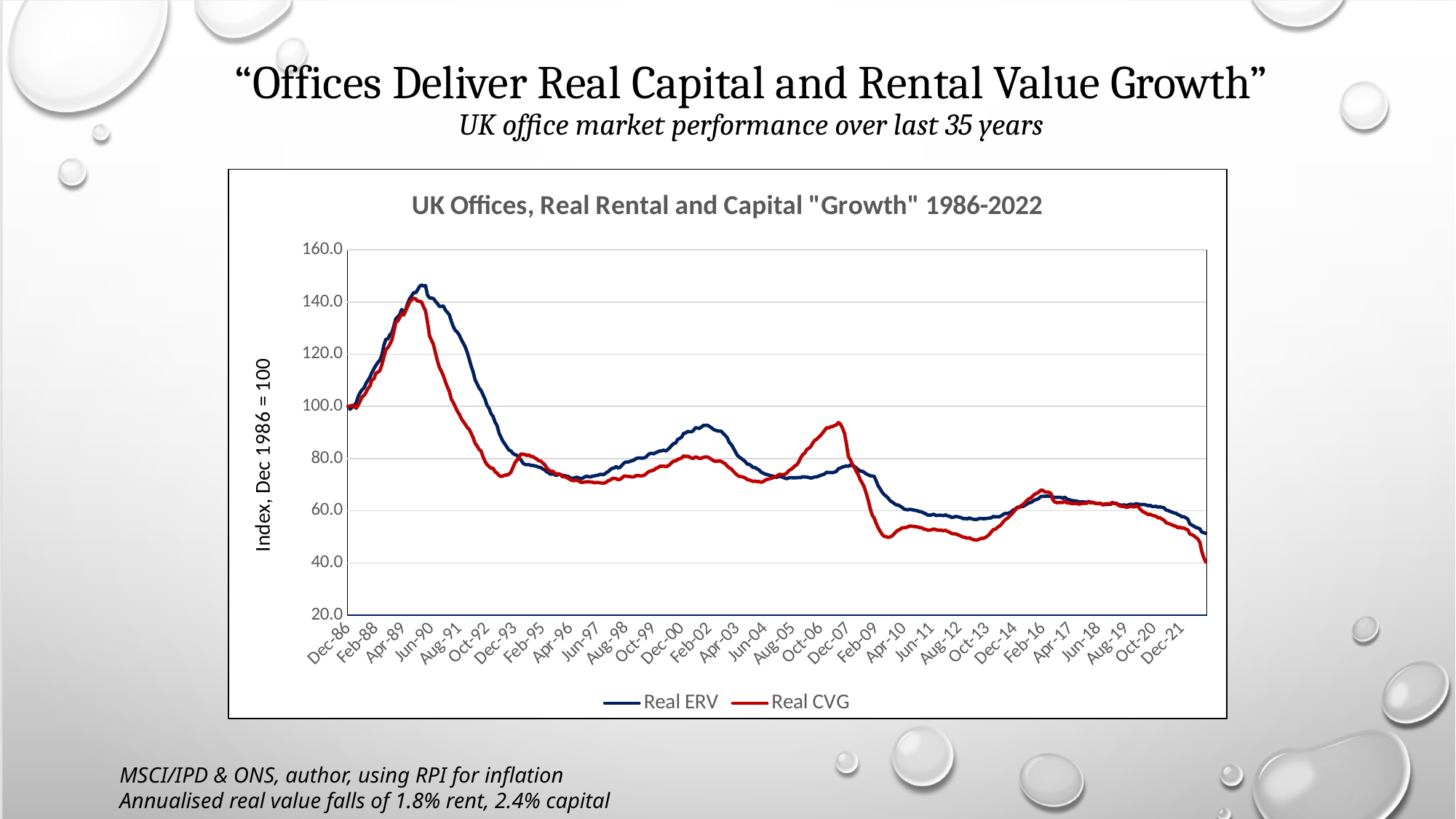
What are the two series named in the chart legend? Real ERV and Real CVG Which series reaches the higher peak around 1990, Real ERV or Real CVG? Real ERV Around Oct-06, which series has the higher value, Real ERV or Real CVG? Real CVG Is the value of Real CVG around Apr-10 greater or less than 60? less Is the value of Real CVG at Dec-21 greater or less than 60? less What is the title of the chart? UK Offices, Real Rental and Capital "Growth" 1986-2022 At Dec-21, which series has the lower value, Real ERV or Real CVG? Real CVG What type of chart is shown on the slide? line chart How many series does the chart legend list? 2 According to the y-axis label, what is the index value in Dec 1986? 100 Does the Real CVG series rise or fall between Jun-90 and Oct-92? fall Is the peak value of Real ERV around Jun-90 greater or less than 140? greater